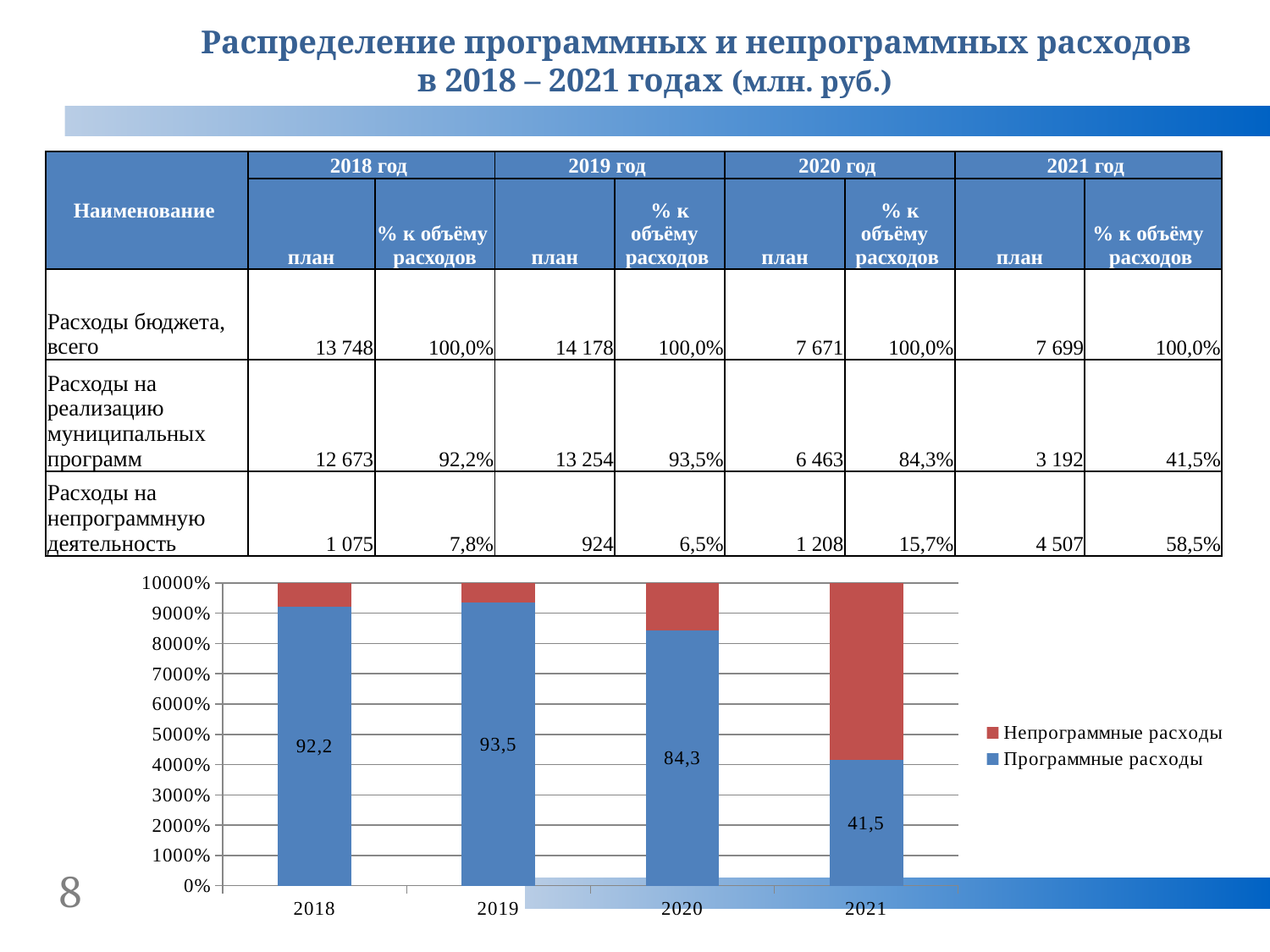
What is the data label for Программные расходы in 2020 on the chart? 84,3 What is the difference between the Программные расходы labels for 2019 and 2021 on the chart? 52,0 What is the data label for Программные расходы in 2018 on the chart? 92,2 Which colour represents Непрограммные расходы in the chart legend? red How many series does the chart legend list? 2 What kind of chart is shown at the bottom of the slide? stacked bar chart In which year is the labelled value for Программные расходы the lowest on the chart? 2021 Which year has the larger Программные расходы label on the chart, 2018 or 2020? 2018 In which year is the labelled value for Программные расходы the highest on the chart? 2019 How many years are shown on the x axis of the chart? 4 What is the data label for Программные расходы in 2021 on the chart? 41,5 What is the data label for Программные расходы in 2019 on the chart? 93,5